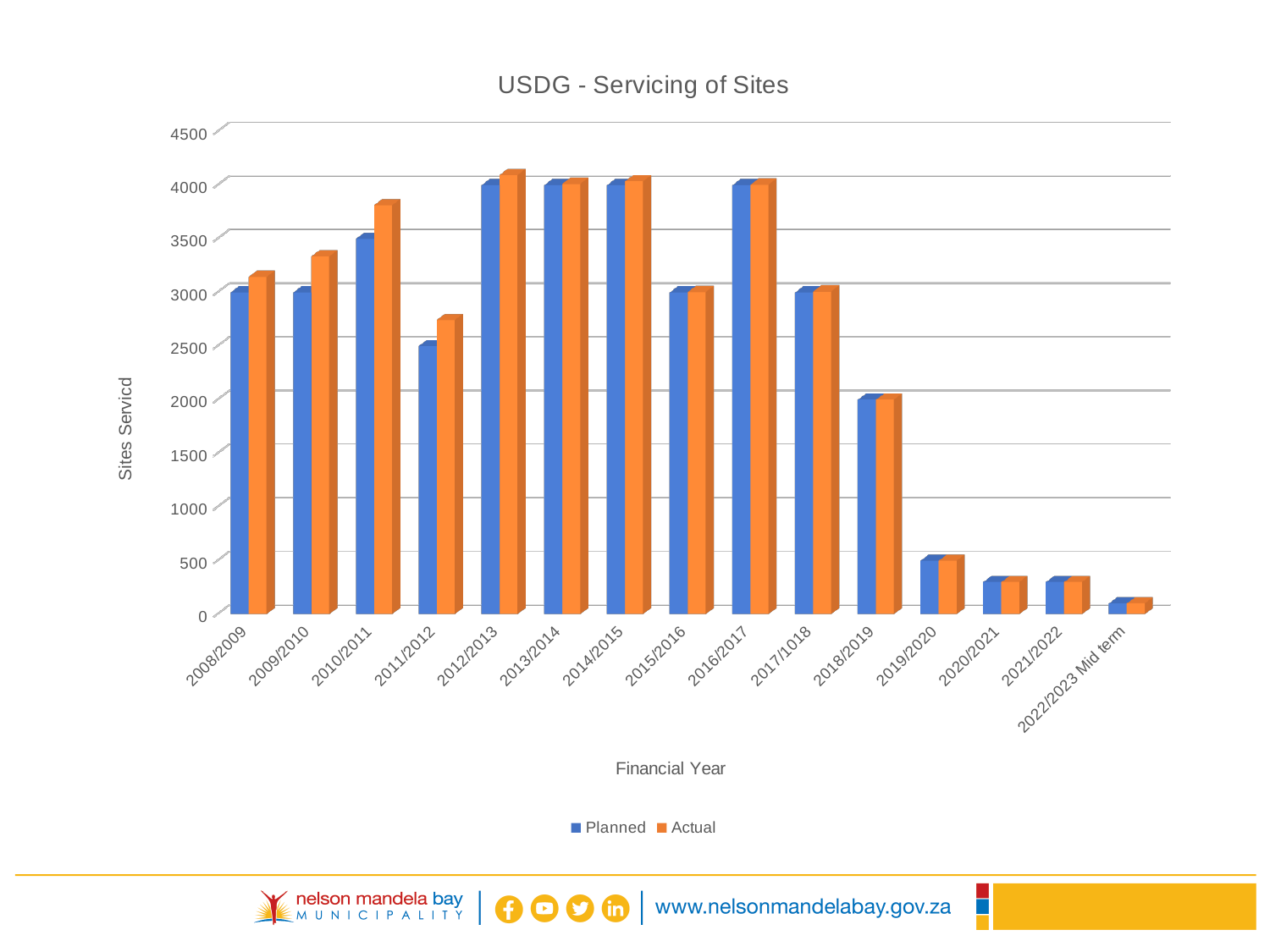
Is the Actual value for 2012/2013 greater or less than 4000? greater Which financial year has the lowest Planned value? 2022/2023 Mid term Is the Actual value for 2010/2011 greater or less than 3500? greater How many financial years are shown on the x axis? 15 How many series does the legend list? 2 What is the Planned value for 2010/2011? 3500 What is the title of the chart? USDG - Servicing of Sites Which is larger for 2009/2010, the Planned value or the Actual value? Actual Is the Actual value for 2011/2012 greater or less than 3000? less What is the Planned value for 2018/2019? 2000 What kind of chart is shown on the slide? bar chart What is the Planned value for 2011/2012? 2500